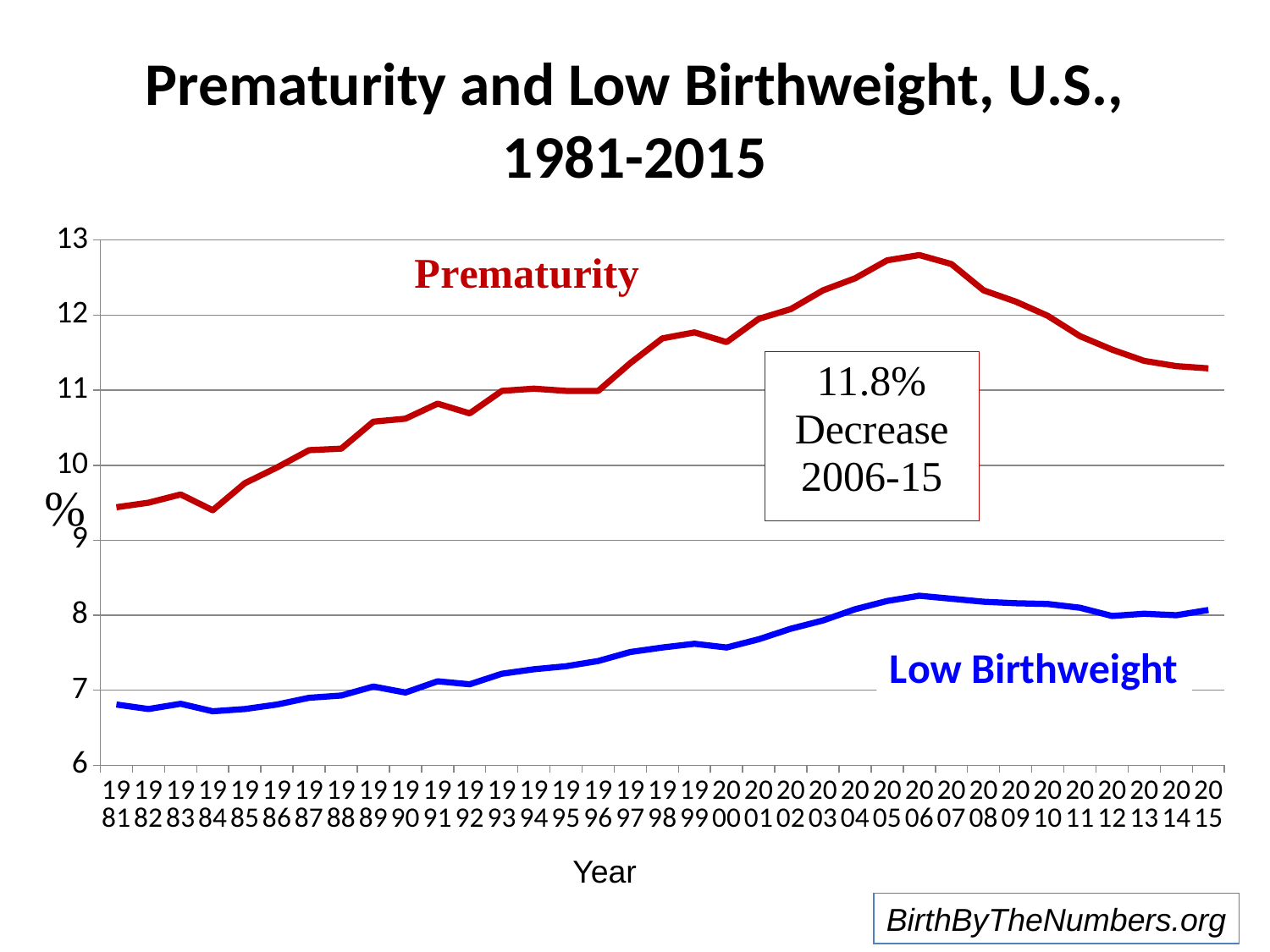
Which series has the higher value in 2015, Prematurity or Low Birthweight? Prematurity What kind of chart is shown on the slide? line chart Is the Prematurity value for 2006 greater or less than 12? greater How many data series are plotted on the chart? 2 How many years are shown along the x axis? 35 What is the title of the chart? Prematurity and Low Birthweight, U.S., 1981-2015 In which year does the Prematurity line reach its highest value? 2006 Does the Prematurity line rise or fall between 2006 and 2015? fall Is the Prematurity value for 1981 greater or less than 10? less Which series is plotted in red? Prematurity Is the Low Birthweight value for 1984 greater or less than 7? less According to the annotation on the chart, by what percentage did prematurity decrease from 2006 to 2015? 11.8%